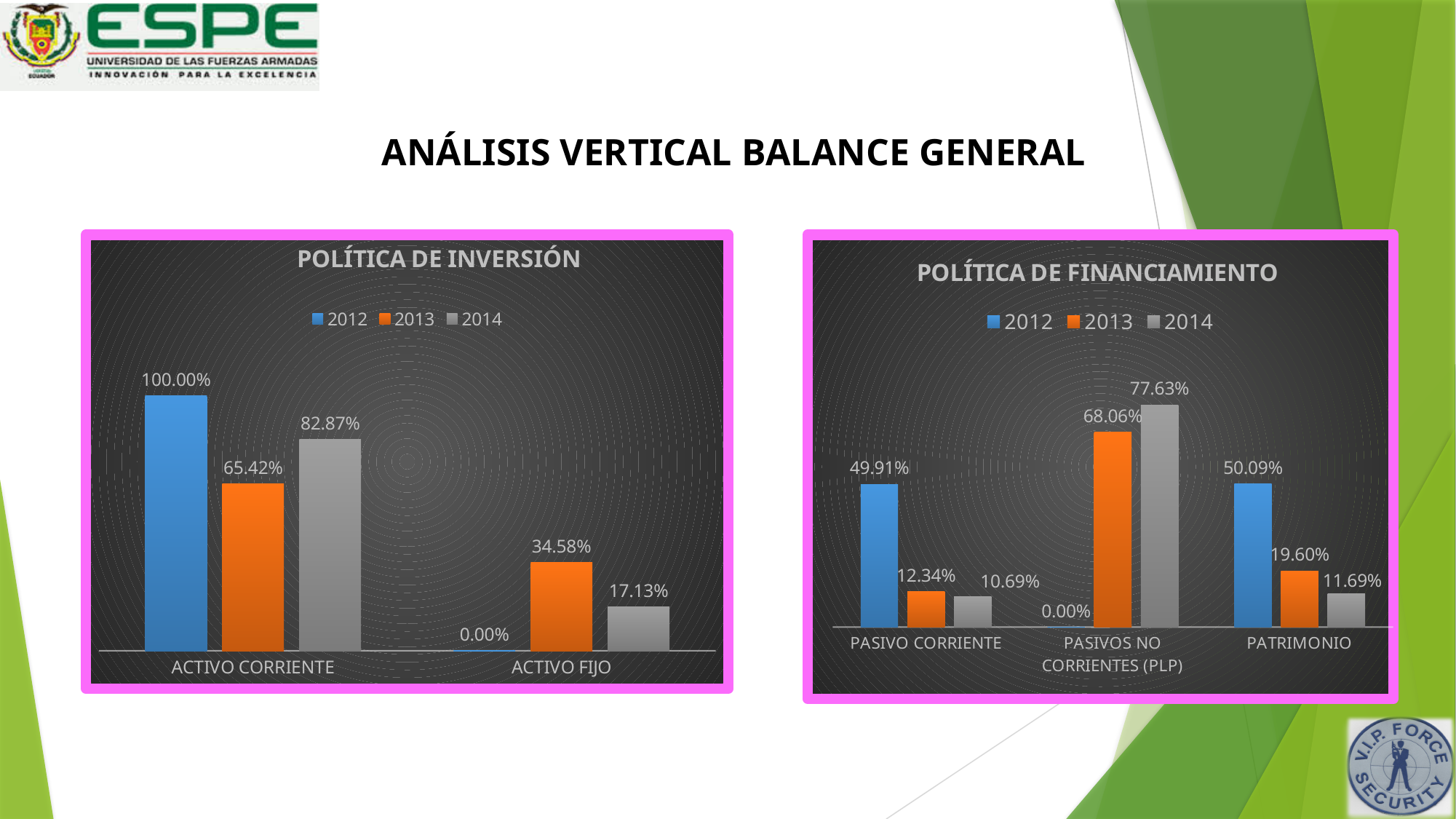
In the POLÍTICA DE FINANCIAMIENTO chart, how many categories are shown on the x axis? 3 In the POLÍTICA DE FINANCIAMIENTO chart, what is the 2012 value for PATRIMONIO? 50.09% What kind of chart is POLÍTICA DE FINANCIAMIENTO? Bar chart In the POLÍTICA DE FINANCIAMIENTO chart, what is the 2014 value for PASIVOS NO CORRIENTES (PLP)? 77.63% In the POLÍTICA DE INVERSIÓN chart, how many series does the legend list? 3 In the POLÍTICA DE INVERSIÓN chart, which year has the highest value for ACTIVO CORRIENTE? 2012 In the POLÍTICA DE INVERSIÓN chart, what is the 2013 value for ACTIVO CORRIENTE? 65.42% In the POLÍTICA DE INVERSIÓN chart, what is the difference between the 2013 and 2014 values for ACTIVO FIJO? 17.45% In the POLÍTICA DE INVERSIÓN chart, what is the 2014 value for ACTIVO FIJO? 17.13% In the POLÍTICA DE FINANCIAMIENTO chart, what is the difference between the 2012 values for PATRIMONIO and PASIVO CORRIENTE? 0.18% In the POLÍTICA DE FINANCIAMIENTO chart, is the 2013 value for PATRIMONIO larger or smaller than the 2013 value for PASIVO CORRIENTE? Larger In the POLÍTICA DE FINANCIAMIENTO chart, which category has the lowest 2014 value? PASIVO CORRIENTE